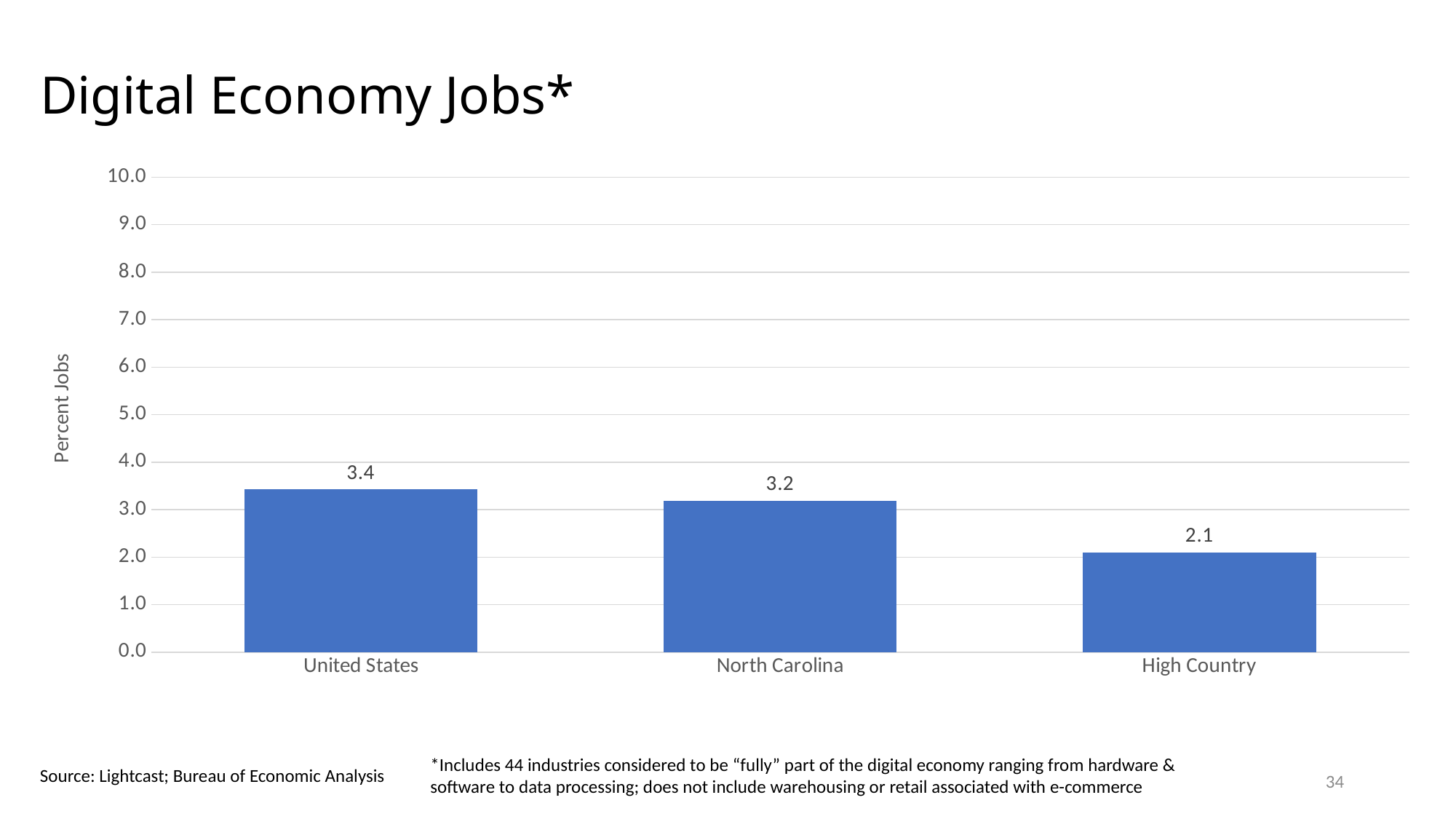
Is the value for High Country greater or less than 3.0? less Which is larger, the value for North Carolina or the value for High Country? North Carolina What is the difference between the values for North Carolina and High Country? 1.1 What kind of chart is shown on the slide? bar chart What is the value for North Carolina? 3.2 What is the value for United States? 3.4 What is the difference between the values for United States and High Country? 1.3 What is the value for High Country? 2.1 How many categories are shown on the chart? 3 What is the label of the vertical axis? Percent Jobs Which category has the lowest value? High Country Which category has the highest value? United States